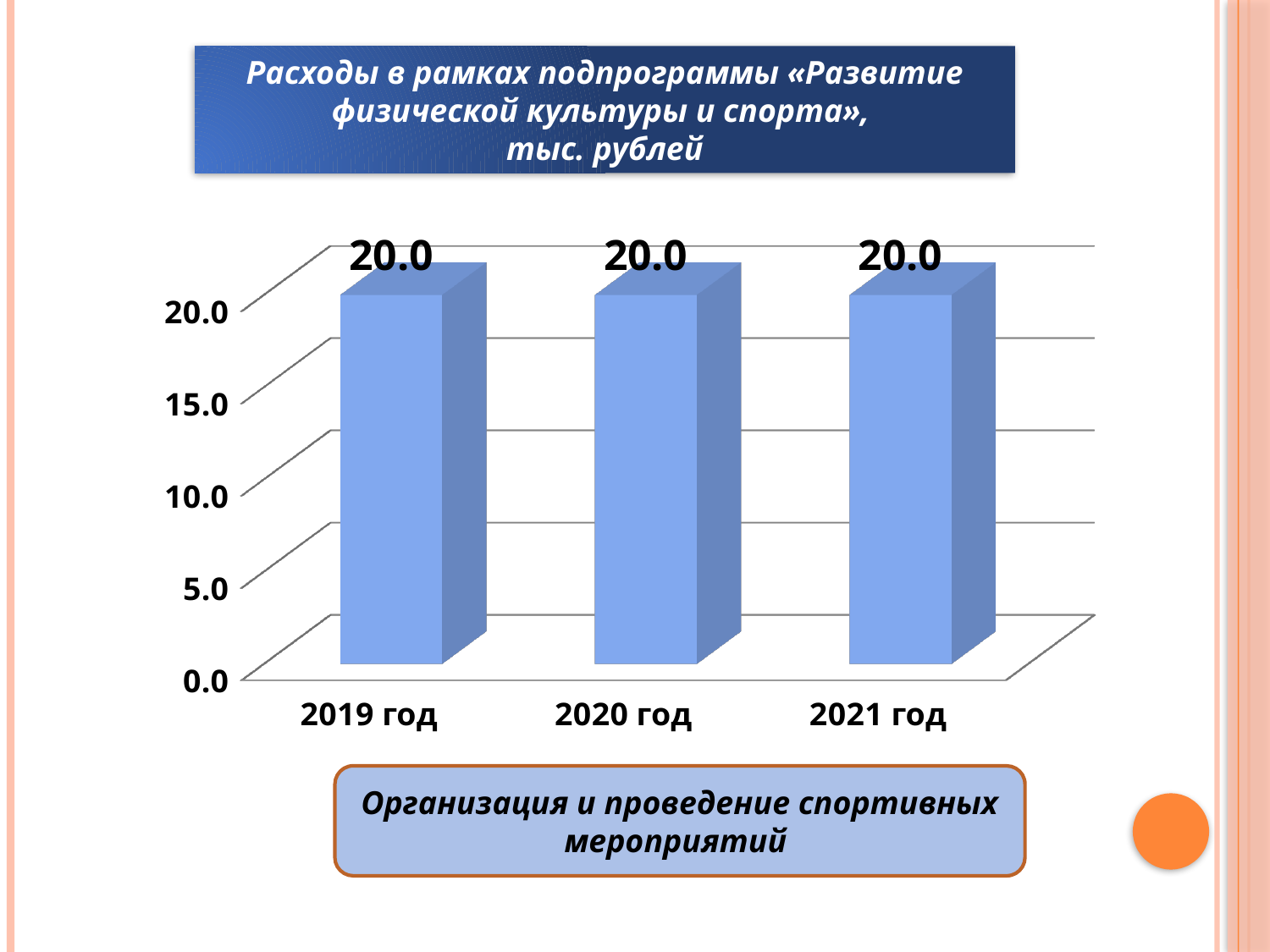
What is the value for 2020 год? 20.0 Is the value for 2020 год larger than, smaller than, or equal to the value for 2019 год? equal Is the value for 2021 год greater or less than 15.0? greater What text appears in the box below the chart? Организация и проведение спортивных мероприятий What is the difference between the values for 2021 год and 2019 год? 0.0 How many categories are shown on the x axis? 3 Is the value for 2019 год greater or less than 10.0? greater What is the value for 2019 год? 20.0 What kind of chart is shown on the slide? bar chart What is the value for 2021 год? 20.0 Do the values rise, fall or stay the same from 2019 год to 2021 год? stay the same In what units are the values on the chart expressed, according to the title? тыс. рублей